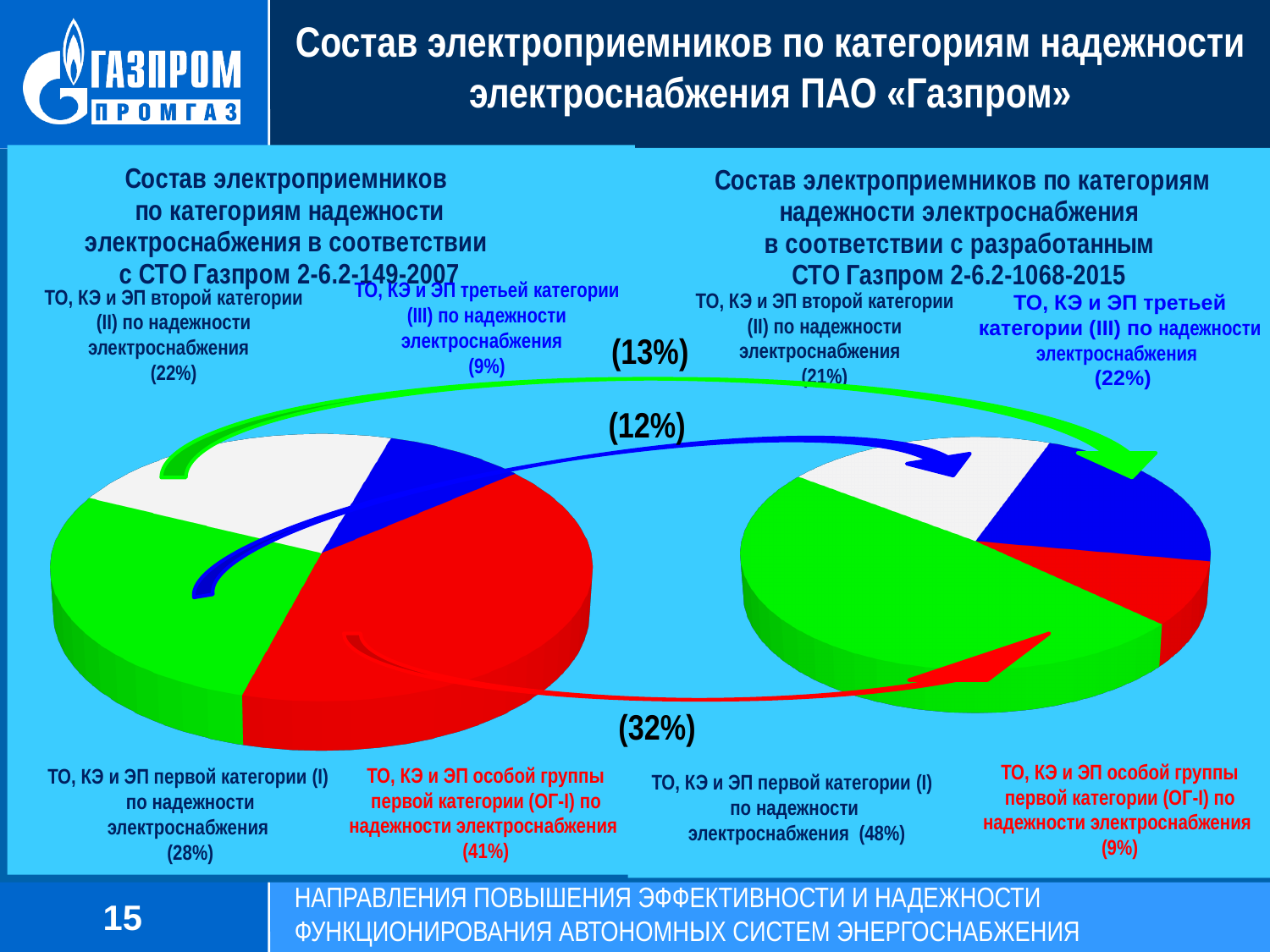
In the right chart (СТО Газпром 2-6.2-1068-2015), what share is shown for ТО, КЭ и ЭП первой категории (I)? 48% What is the difference between the share of ТО, КЭ и ЭП первой категории (I) in the right chart (48%) and in the left chart (28%)? 20% In the right chart (СТО Газпром 2-6.2-1068-2015), what share is shown for ТО, КЭ и ЭП второй категории (II)? 21% In the left chart (СТО Газпром 2-6.2-149-2007), which category has the largest share? ТО, КЭ и ЭП особой группы первой категории (ОГ-I) How many slices does the right chart (СТО Газпром 2-6.2-1068-2015) have? 4 What colour represents ТО, КЭ и ЭП особой группы первой категории (ОГ-I) in both pie charts? red In the left chart (СТО Газпром 2-6.2-149-2007), what share is shown for ТО, КЭ и ЭП особой группы первой категории (ОГ-I)? 41% Which is larger: the share of ТО, КЭ и ЭП третьей категории (III) in the left chart or in the right chart? right chart (22%) In the right chart (СТО Газпром 2-6.2-1068-2015), which category has the smallest share? ТО, КЭ и ЭП особой группы первой категории (ОГ-I) In the left chart (СТО Газпром 2-6.2-149-2007), what is the combined share of ТО, КЭ и ЭП первой категории (I) and ТО, КЭ и ЭП второй категории (II)? 50% In the left chart (СТО Газпром 2-6.2-149-2007), what share is shown for ТО, КЭ и ЭП третьей категории (III)? 9% What kind of chart is the left chart (СТО Газпром 2-6.2-149-2007)? pie chart